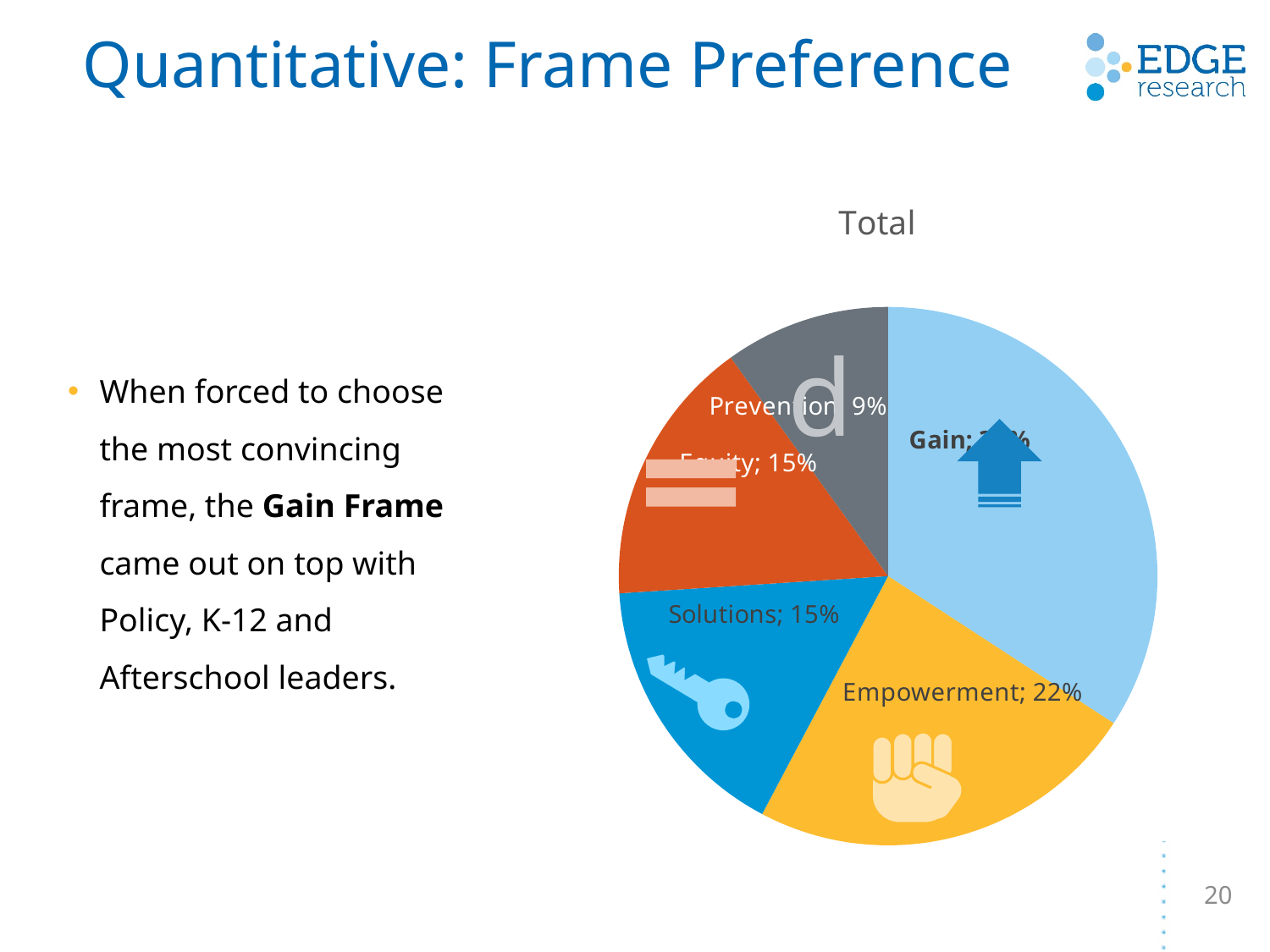
What is the difference in percentage points between Empowerment and Prevention? 13 percentage points Which frame has the smallest slice of the pie? Prevention What percentage does the Empowerment slice show? 22% Which slice is larger, Prevention or Solutions? Solutions What percentage does the Prevention slice show? 9% How many slices does the pie chart have? 5 Which slice is larger, Empowerment or Solutions? Empowerment What is the difference in percentage points between Empowerment and Solutions? 7 percentage points What kind of chart is shown on the slide? pie chart What is the title of the pie chart? Total Which frame has the largest slice of the pie? Gain What percentage does the Solutions slice show? 15%